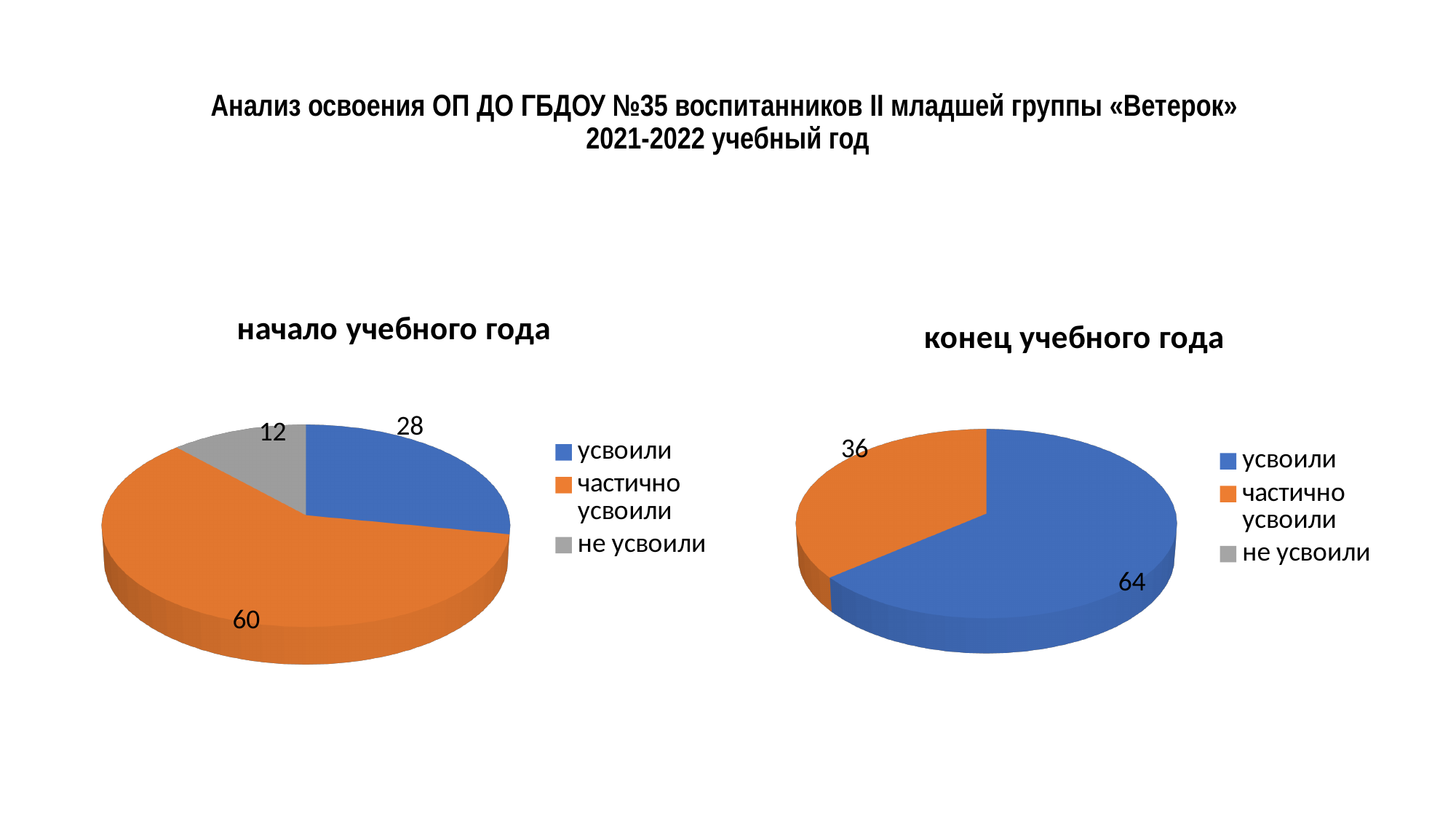
In the 'начало учебного года' chart, which category has the largest slice? частично усвоили In the 'конец учебного года' chart, what is the value for 'частично усвоили'? 36 How many entries does the legend of the 'начало учебного года' chart list? 3 In the 'конец учебного года' chart, which category has the largest slice? усвоили In the 'начало учебного года' chart, what is the value for 'не усвоили'? 12 In the 'конец учебного года' chart, what is the value for 'усвоили'? 64 What type of chart is the 'конец учебного года' chart? pie chart In the 'начало учебного года' chart, what is the value for 'усвоили'? 28 In the 'конец учебного года' chart, what is the difference between 'усвоили' and 'частично усвоили'? 28 In the 'начало учебного года' chart, which category has the smallest slice? не усвоили In the 'начало учебного года' chart, what is the difference between 'частично усвоили' and 'усвоили'? 32 In the 'начало учебного года' chart, what is the value for 'частично усвоили'? 60